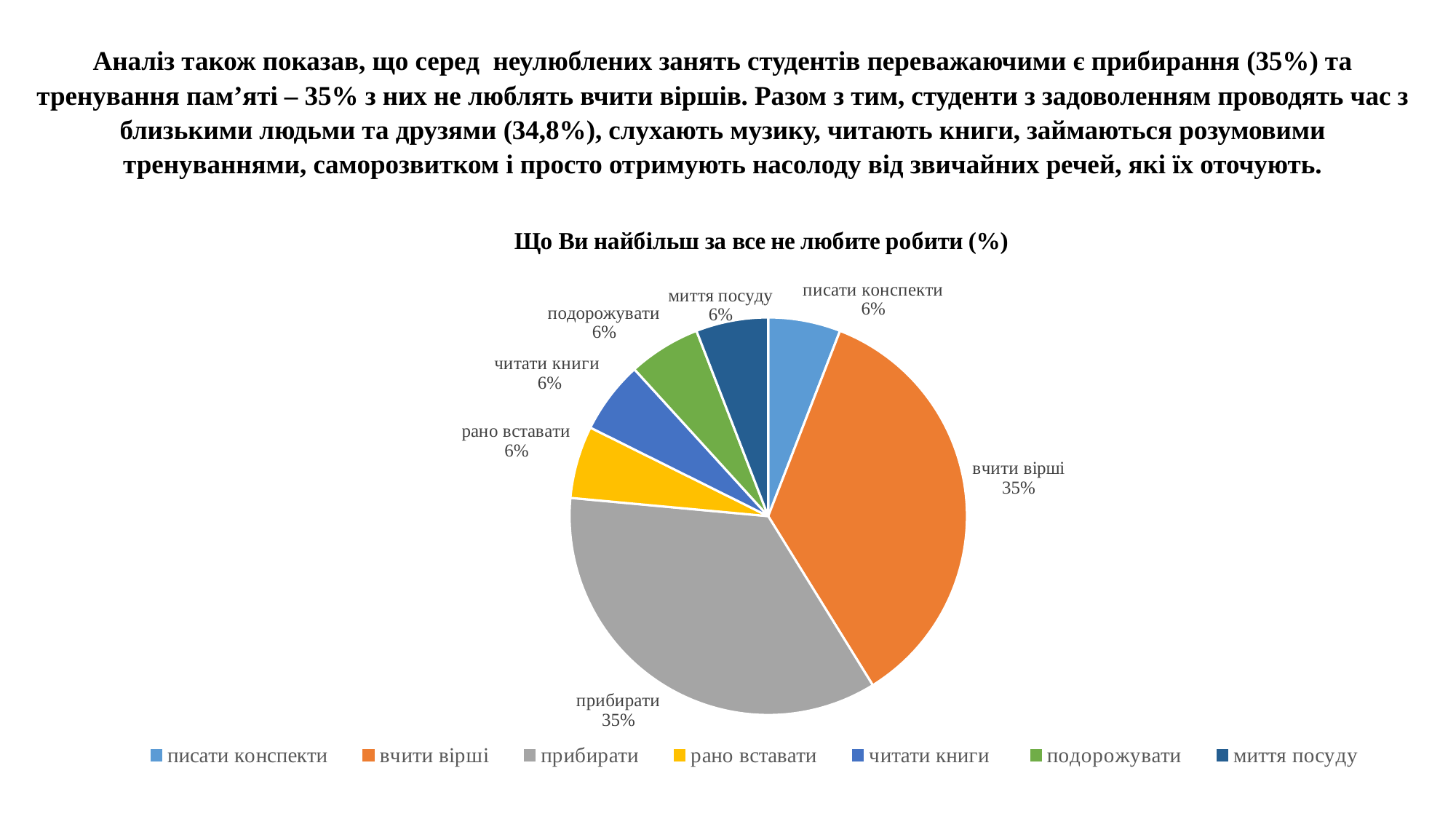
What value is shown for 'рано вставати'? 6% What is the difference in percentage points between 'прибирати' and 'подорожувати'? 29 What value is shown for 'миття посуду'? 6% What share of the pie is labelled for 'вчити вірші'? 35% Which colour is used for the 'прибирати' slice? grey What kind of chart is shown on the slide? pie chart What is the title of the chart? Що Ви найбільш за все не любите робити (%) What value is shown for 'писати конспекти'? 6% Which is larger, the slice for 'вчити вірші' or the slice for 'читати книги'? вчити вірші How many categories (slices) does the pie chart have? 7 How many entries does the legend list? 7 What share of the pie is labelled for 'прибирати'? 35%